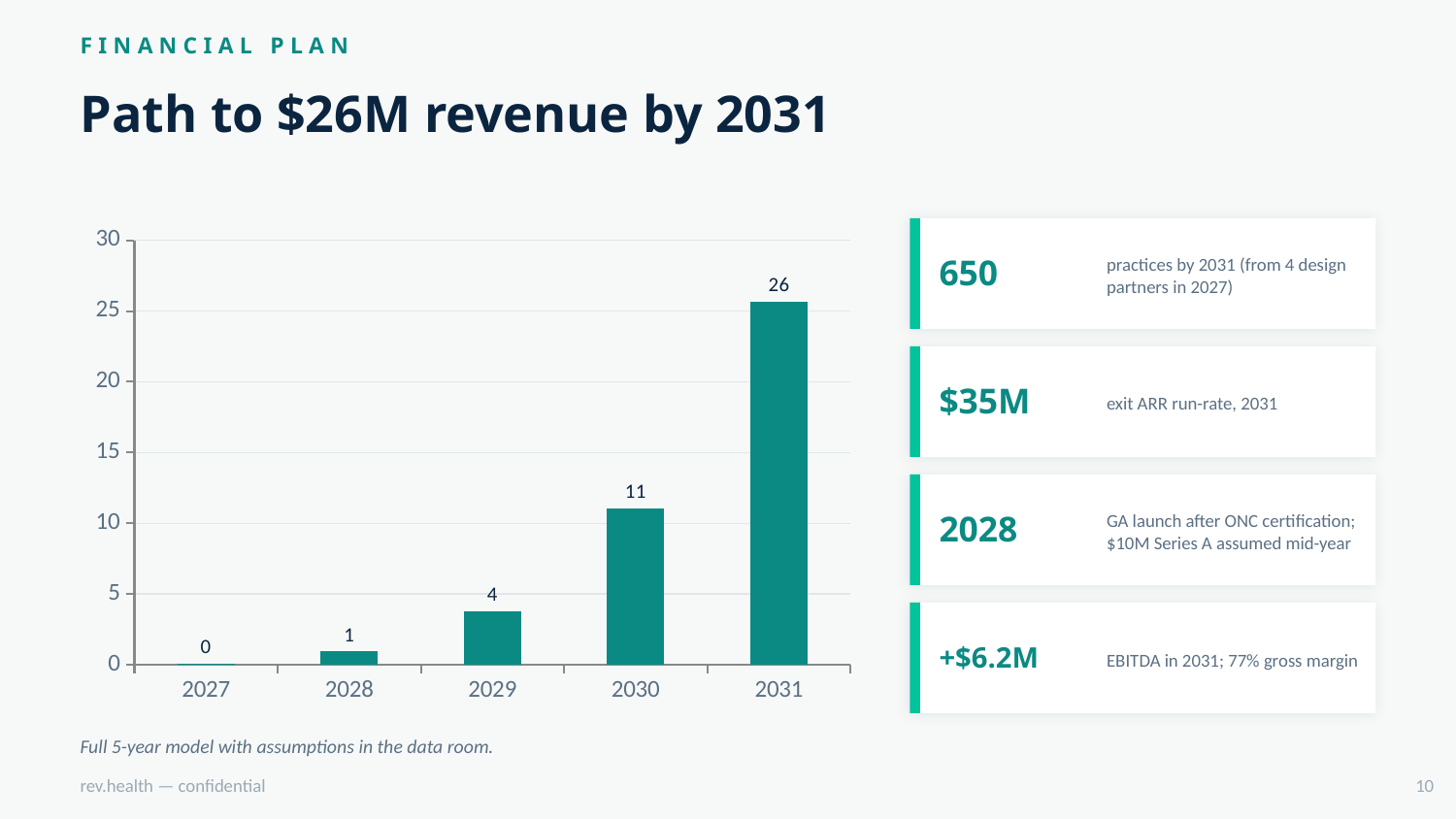
How many years are shown on the x axis? 5 Which year has the highest value? 2031 Which is larger, the value for 2029 or the value for 2030? 2030 What is the value shown for 2031? 26 What is the difference between the values for 2031 and 2030? 15 Is the value for 2031 greater or less than 25? greater What is the value shown for 2030? 11 What kind of chart is shown? bar chart Do the values rise or fall from 2027 to 2031? rise Which year has the lowest value? 2027 What is the value shown for 2028? 1 What is the value shown for 2029? 4